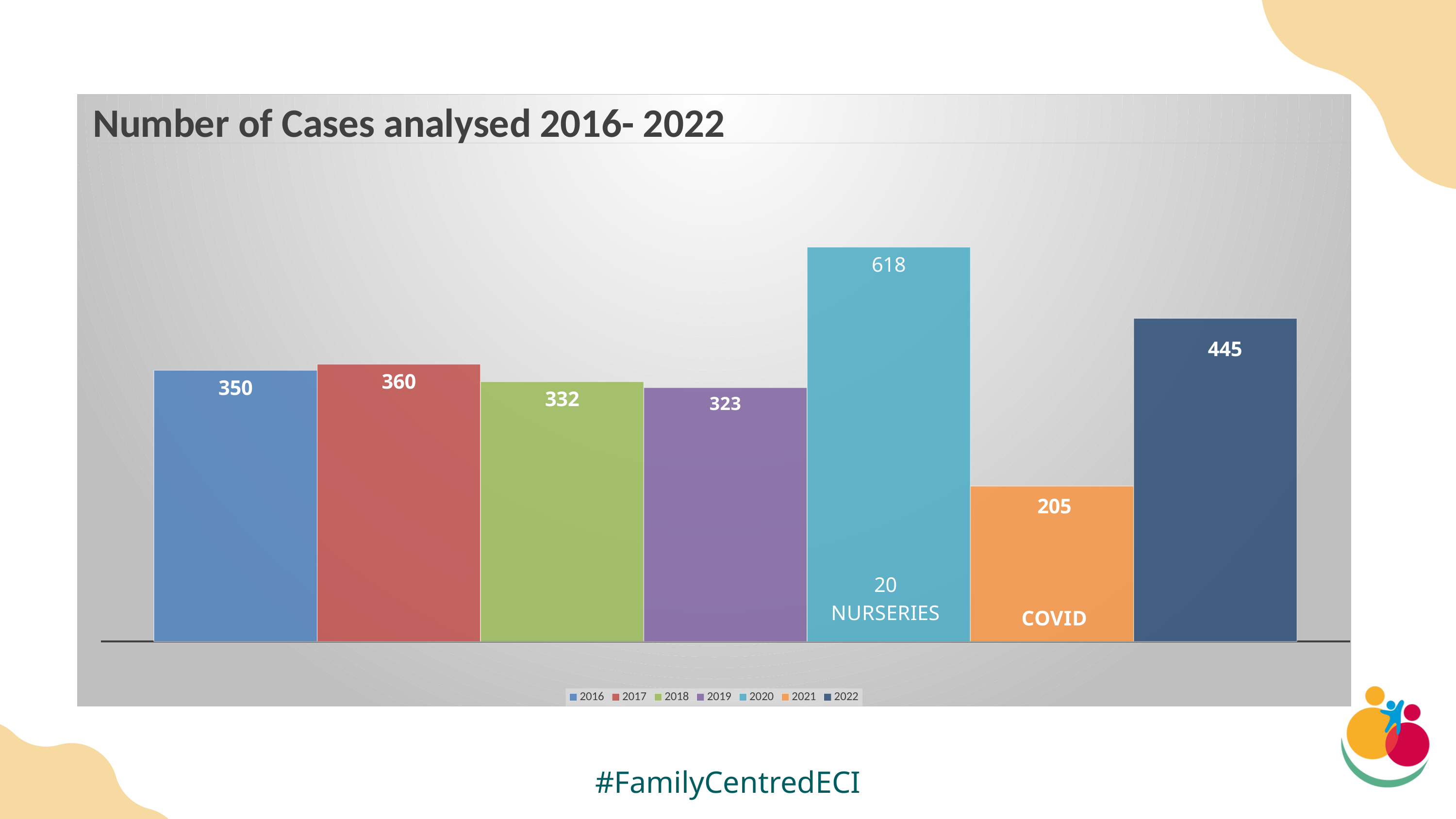
What is the number of cases analysed in 2020? 618 What is the number of cases analysed in 2021? 205 Which year has the lowest number of cases analysed? 2021 Which year has the highest number of cases analysed? 2020 How many years are shown in the chart? 7 What is the difference between the number of cases in 2017 and 2018? 28 What is the difference between the number of cases in 2020 and 2021? 413 What type of chart is shown on the slide? Bar chart What is the number of cases analysed in 2016? 350 Which year has more cases analysed, 2016 or 2017? 2017 What is the title of the chart? Number of Cases analysed 2016- 2022 What is the number of cases analysed in 2022? 445